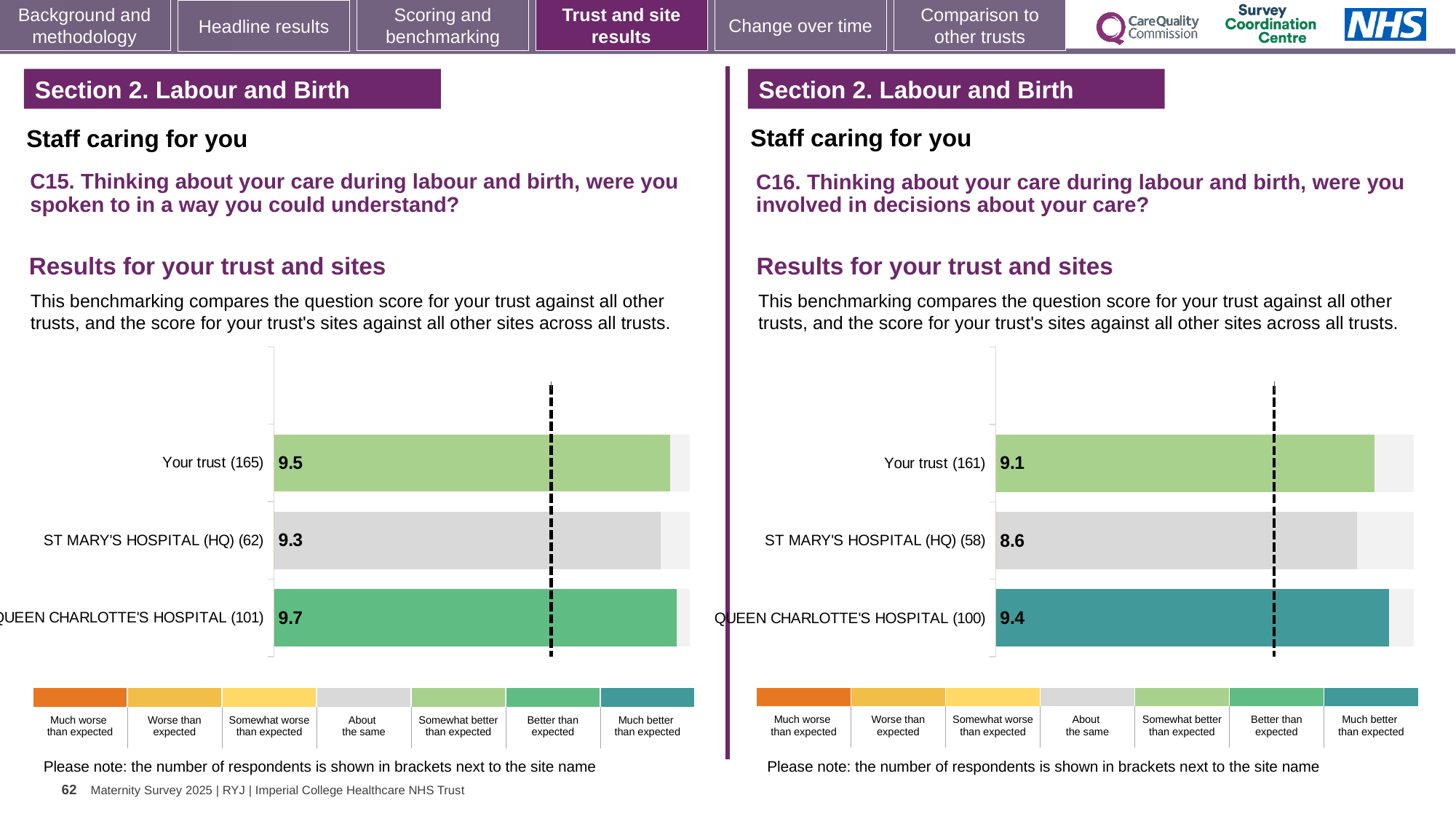
On the C16 chart (right), what is the score for QUEEN CHARLOTTE'S HOSPITAL? 9.4 On the C15 chart (left), what is the score for Your trust? 9.5 On the C15 chart (left), what is the difference between the scores for QUEEN CHARLOTTE'S HOSPITAL and Your trust? 0.2 How many bars are plotted on the C16 chart (right)? 3 Is the score for Your trust higher on the C15 chart (left) or the C16 chart (right)? C15 chart (left) On the C16 chart (right), how many respondents are shown in brackets for Your trust? 161 On the C15 chart (left), which site or trust has the highest score? QUEEN CHARLOTTE'S HOSPITAL On the C15 chart (left), what is the score for ST MARY'S HOSPITAL (HQ)? 9.3 On the C16 chart (right), what is the score for ST MARY'S HOSPITAL (HQ)? 8.6 On the C16 chart (right), which site or trust has the lowest score? ST MARY'S HOSPITAL (HQ) On the C16 chart (right), what is the difference between the scores for QUEEN CHARLOTTE'S HOSPITAL and ST MARY'S HOSPITAL (HQ)? 0.8 What type of chart is used on the C15 chart (left)? Bar chart